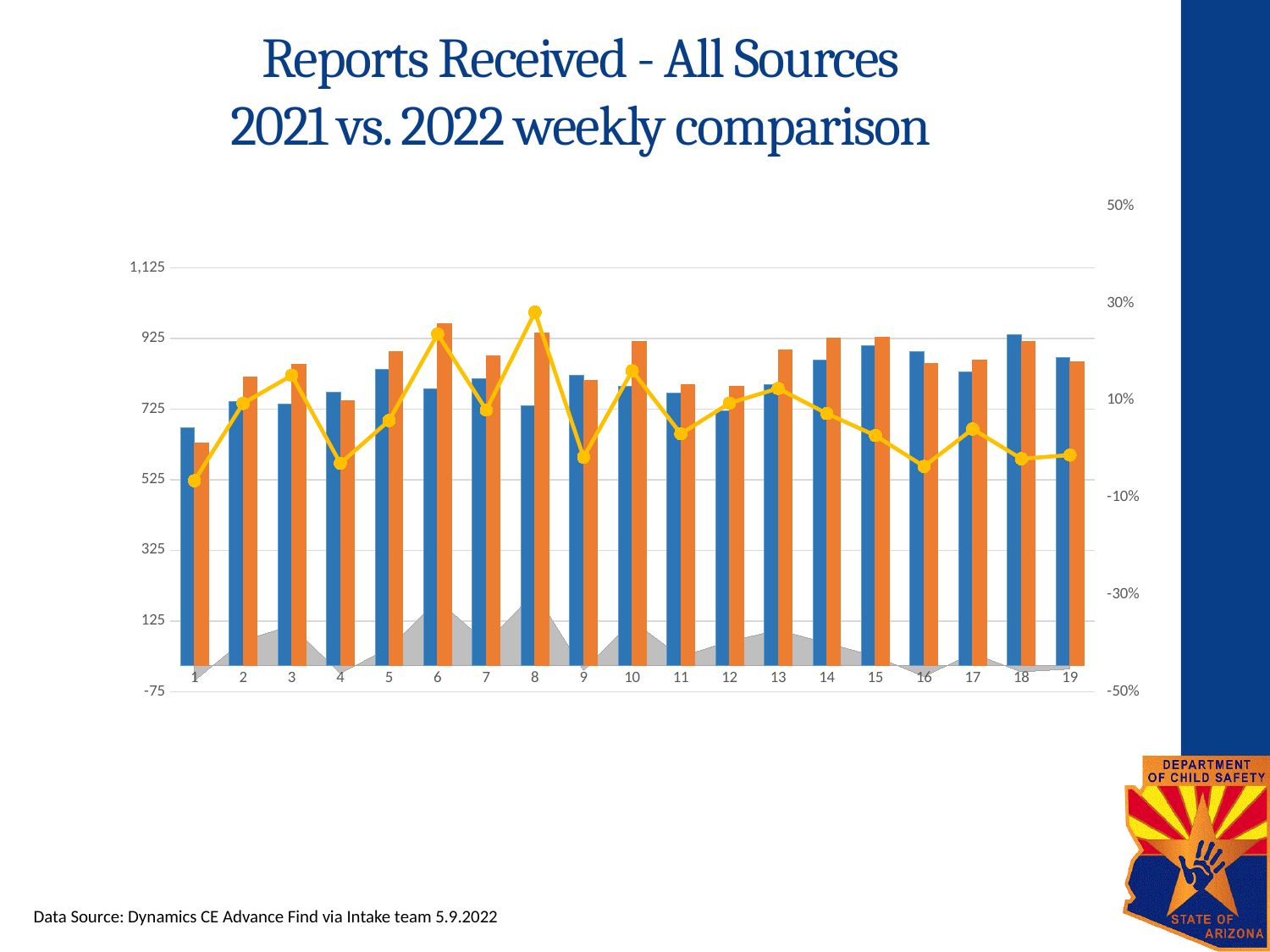
Is the blue bar for week 1 greater or less than 725? less At which week is the orange bar the lowest? Week 1 Is the blue bar for week 9 greater or less than 725? greater How many weeks are shown along the x axis of the chart? 19 What is the title of the chart on this slide? Reports Received - All Sources 2021 vs. 2022 weekly comparison Is the orange bar for week 3 greater or less than 925? less In week 6, which bar is taller, the blue bar or the orange bar? The orange bar At which week does the yellow line reach its highest point? Week 8 What kind of chart is shown on the slide? A combination chart with bars, a line and a shaded area